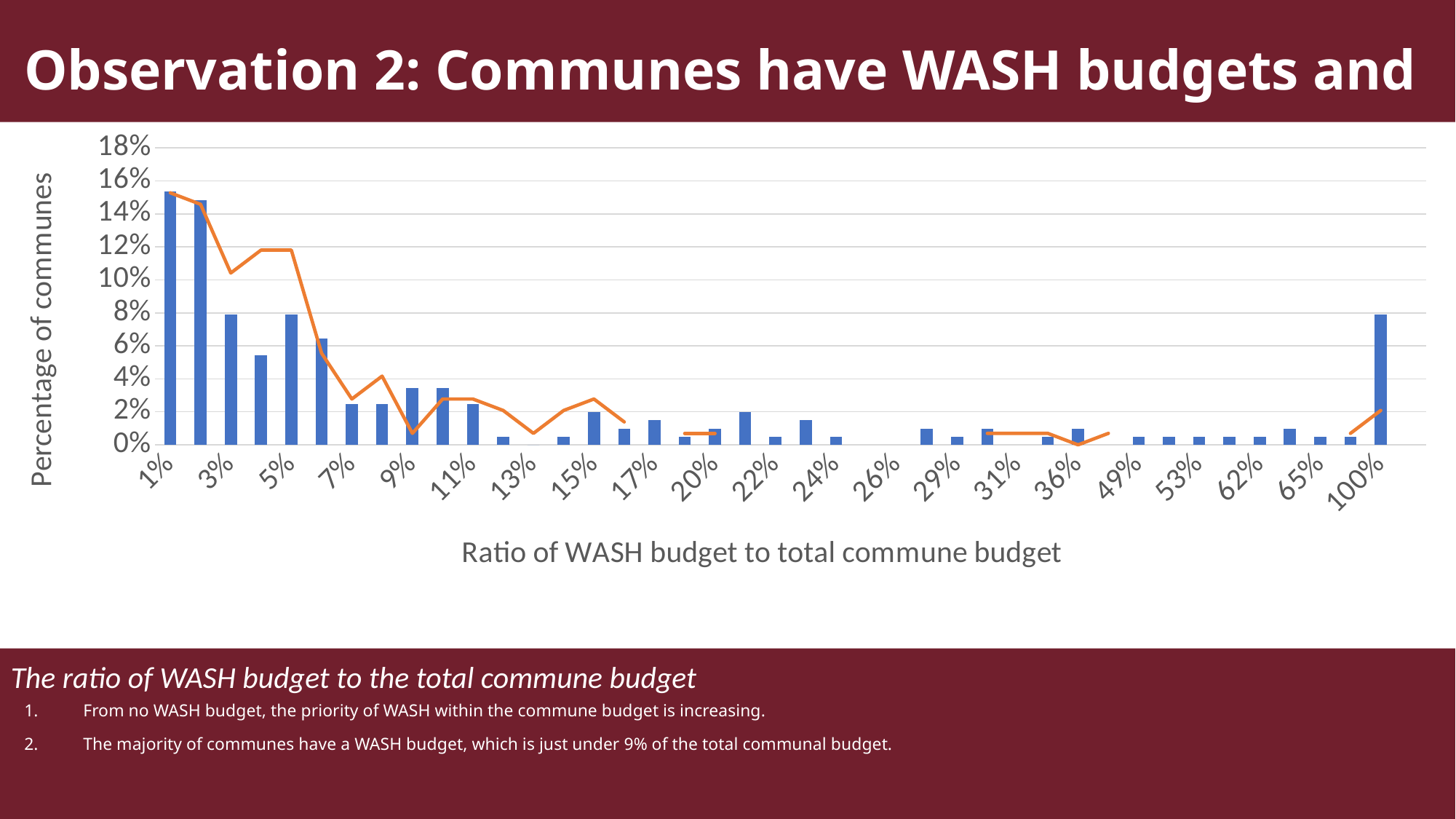
Is the bar for the 100% ratio greater or less than 6%? greater Which bar is taller, the one for the 5% ratio or the one for the 7% ratio? 5% What kind of chart is shown on the slide? bar chart with a line overlay Do the bar values generally rise or fall as the ratio increases from 1% to 26%? fall Is the bar for the 1% ratio greater or less than 14%? greater Which bar is taller, the one for the 100% ratio or the one for the 9% ratio? 100% Is the bar for the 5% ratio greater or less than 6%? greater Which ratio category has the lowest bar among 1%, 3%, 5% and 7%? 7% What is the x-axis title of the chart? Ratio of WASH budget to total commune budget What is the y-axis title of the chart? Percentage of communes